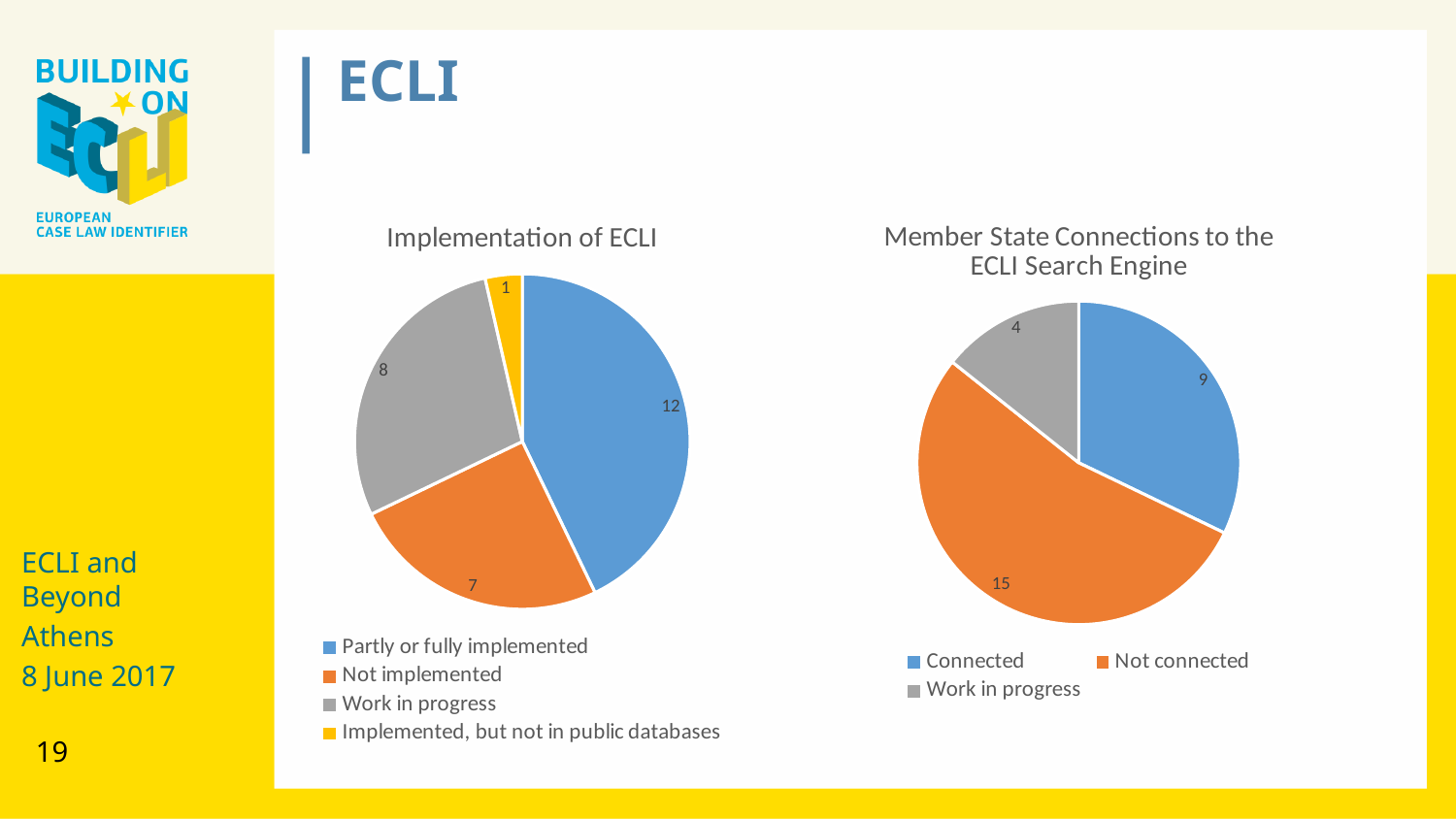
In the 'Member State Connections to the ECLI Search Engine' chart, which category has the smallest slice? Work in progress In the 'Implementation of ECLI' chart, what is the value for 'Partly or fully implemented'? 12 In the 'Member State Connections to the ECLI Search Engine' chart, what is the value for 'Connected'? 9 In the 'Implementation of ECLI' chart, which category has the largest slice? Partly or fully implemented In the 'Implementation of ECLI' chart, what is the value for 'Work in progress'? 8 In the 'Implementation of ECLI' chart, how many categories does the legend list? 4 In the 'Member State Connections to the ECLI Search Engine' chart, what is the difference between 'Not connected' and 'Work in progress'? 11 In the 'Implementation of ECLI' chart, which category has the smallest slice? Implemented, but not in public databases In the 'Implementation of ECLI' chart, what is the difference between 'Partly or fully implemented' and 'Not implemented'? 5 In the 'Member State Connections to the ECLI Search Engine' chart, which is larger, 'Connected' or 'Not connected'? Not connected In the 'Member State Connections to the ECLI Search Engine' chart, what is the value for 'Not connected'? 15 What type of chart is the 'Member State Connections to the ECLI Search Engine' chart? Pie chart